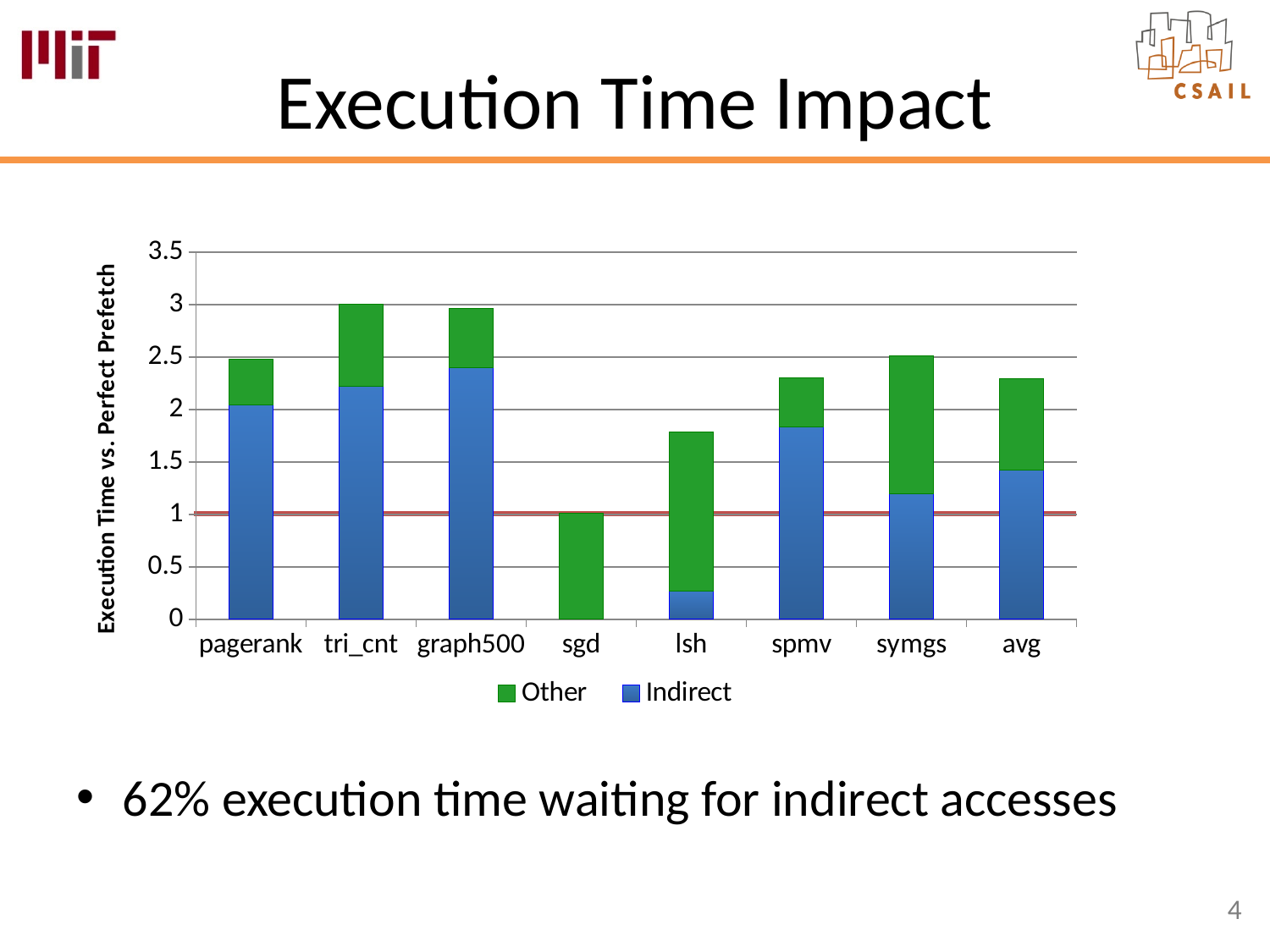
Which series is shown in green in the chart? Other What kind of chart is shown on the slide? stacked bar chart How many series does the chart's legend list? 2 Is the Indirect portion for symgs greater or less than 1.5? less Is the Indirect portion for graph500 greater or less than 2? greater Which has the larger total bar, pagerank or lsh? pagerank How many categories are shown on the x axis of the chart? 8 What is the label of the y axis in the chart? Execution Time vs. Perfect Prefetch Which has the larger total bar, spmv or sgd? spmv Which category has the lowest total bar in the chart? sgd Is the total bar for tri_cnt greater or less than 2.5? greater